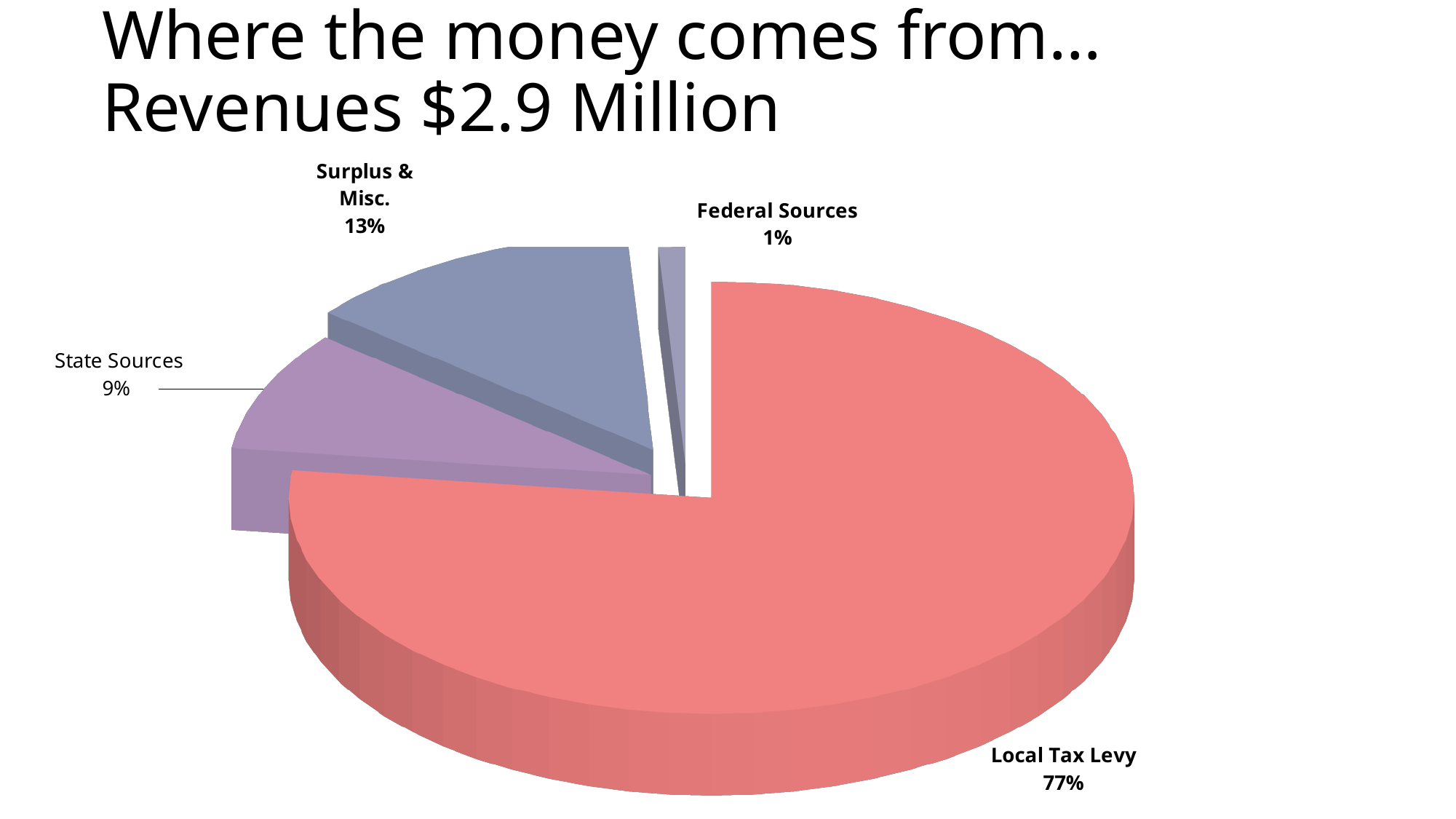
How many revenue sources are shown in the pie chart? 4 What share of revenues comes from Surplus & Misc.? 13% How many percentage points larger is the Local Tax Levy share than the Surplus & Misc. share? 64 What share of revenues comes from State Sources? 9% Which is larger, the share for State Sources or the share for Federal Sources? State Sources What share of revenues comes from Local Tax Levy? 77% Which revenue source has the largest share? Local Tax Levy What kind of chart is shown on the slide? Pie chart What total revenue amount is stated in the slide title? $2.9 Million How many percentage points larger is the Surplus & Misc. share than the State Sources share? 4 Which revenue source has the smallest share? Federal Sources